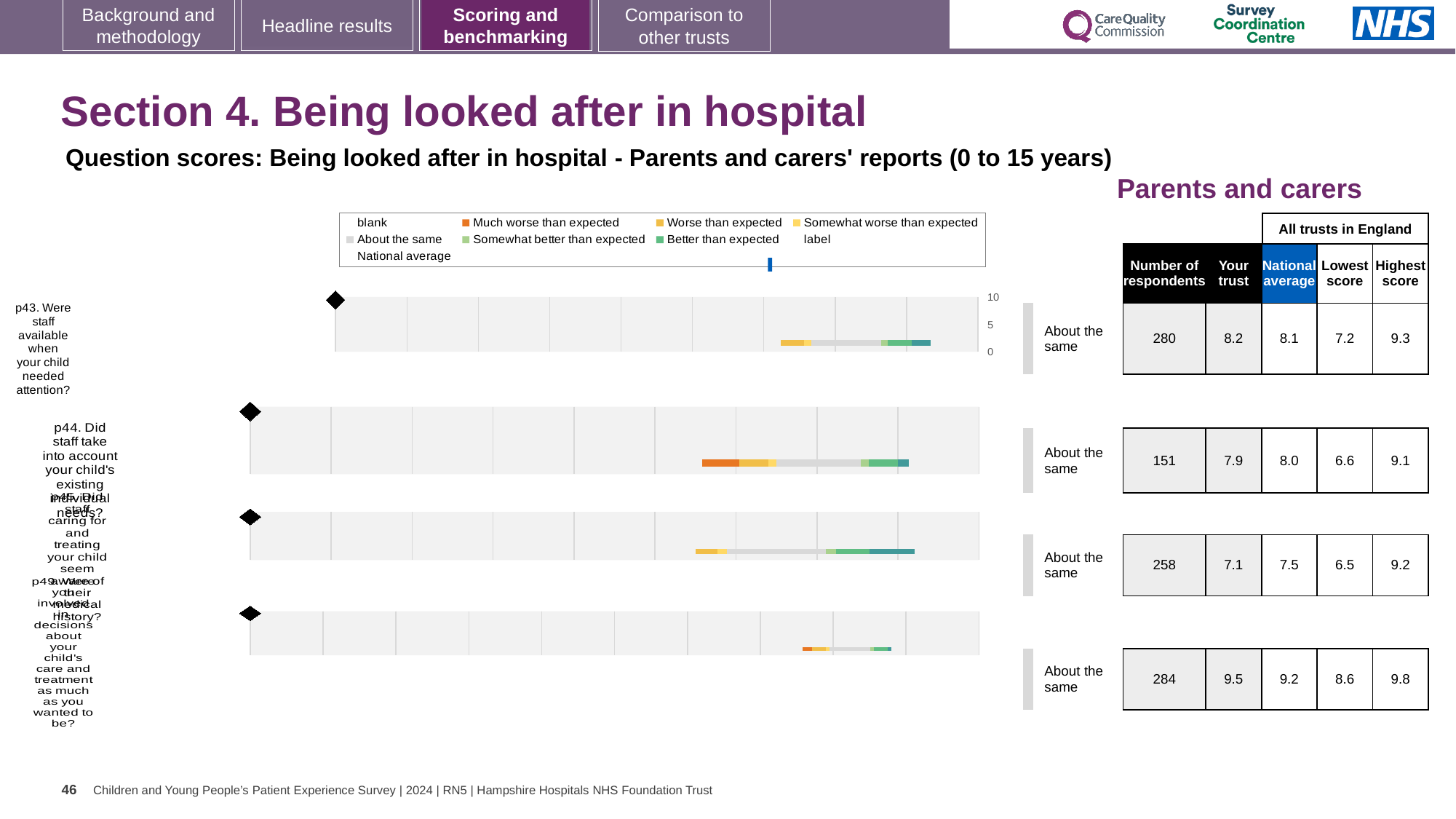
What is the difference between the 'Your trust' score and the national average for p49? 0.3 Which question has the highest 'Your trust' score? p49 Which question has the lowest 'Your trust' score? p45 For p44, which is larger: the 'Your trust' score or the national average? National average How many respondents are listed for the fourth row, p49? 284 What benchmark category label is shown next to each of the four question rows? About the same What is the 'Your trust' score for p43 (Were staff available when your child needed attention?)? 8.2 What is the lowest score across all trusts in England for p45? 6.5 What is the national average score for p44 (Did staff take into account your child's existing individual needs?)? 8.0 What is the difference between the highest score and the lowest score for p43? 2.1 How many questions (rows) are plotted in the chart? 4 What kind of chart is used to show the question scores on this slide? bar chart